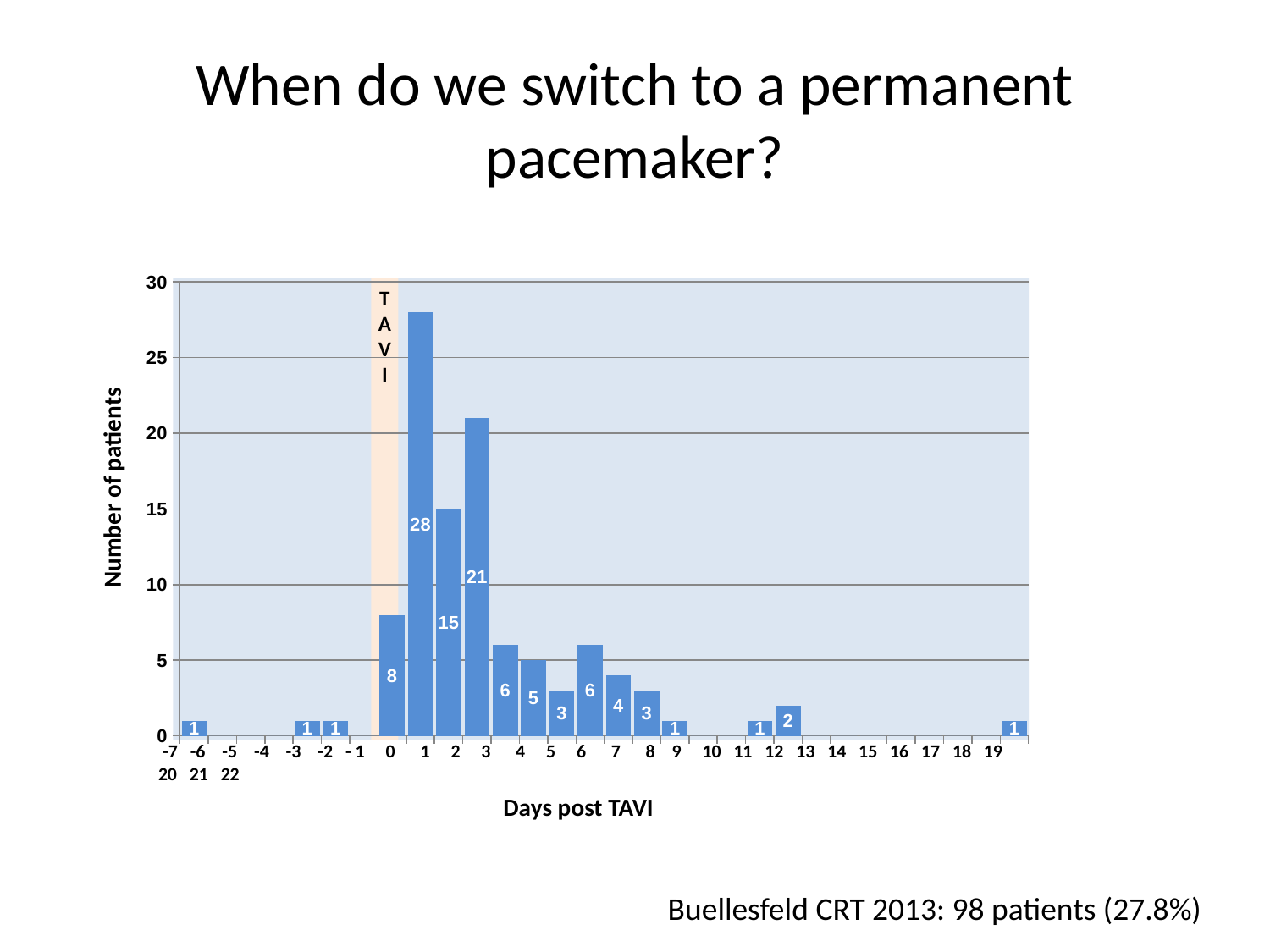
How many patients are shown for day 3 post TAVI? 21 What is the difference in number of patients between day 1 and day 3 post TAVI? 7 How many patients are shown for day 1 post TAVI? 28 What is the total number of patients for days 0, 1, 2 and 3 combined? 72 What kind of chart is shown on the slide? bar chart How many patients are shown for day 0 (the TAVI day)? 8 How many patients are shown for day 2 post TAVI? 15 Which day has more patients, day 2 or day 3 post TAVI? day 3 What is the title of the horizontal axis? Days post TAVI What is the title of the vertical axis? Number of patients Is the value of the tallest bar greater or less than 25? greater What is the highest number of patients shown for any single day on the chart? 28